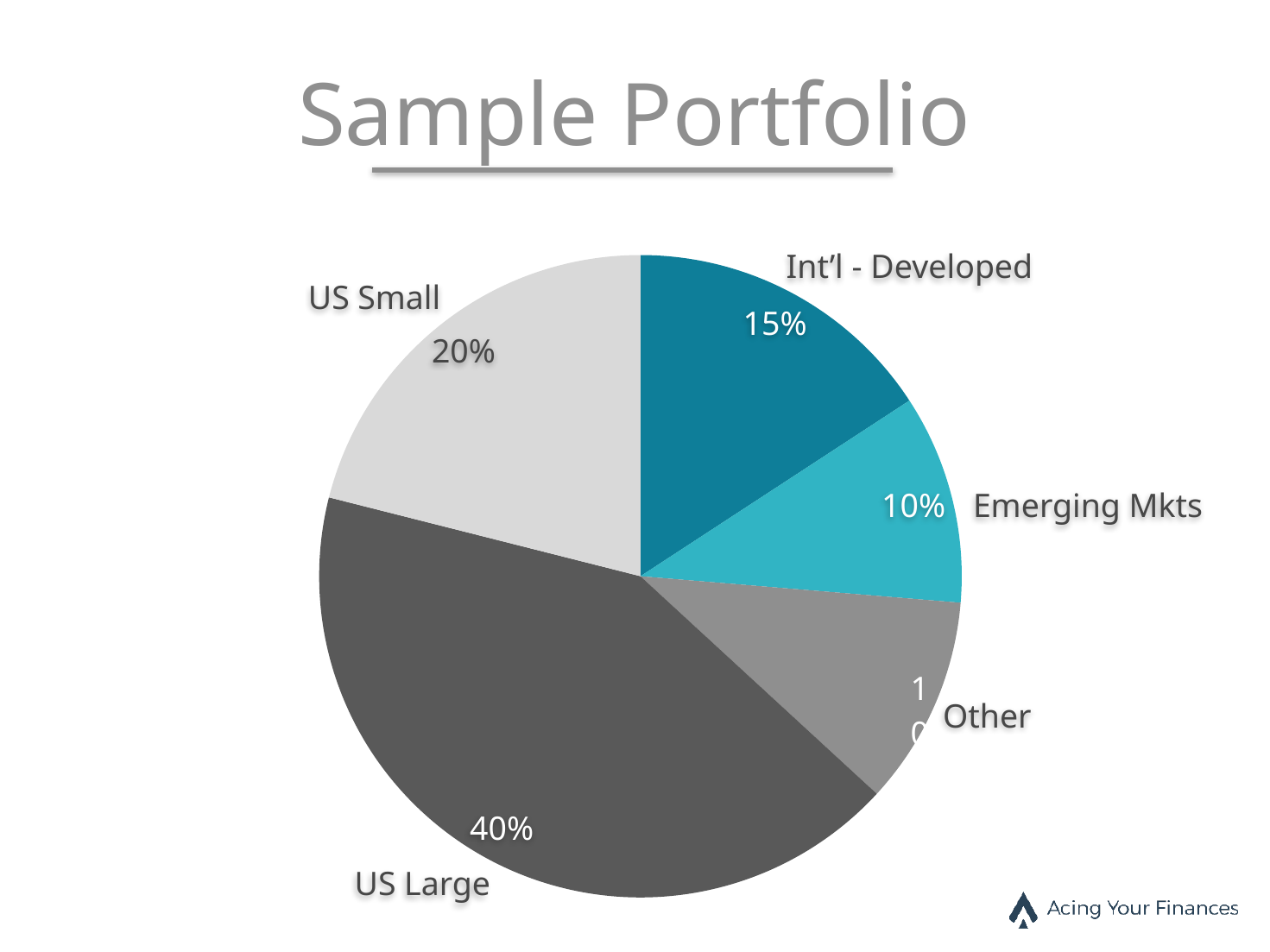
Which is larger, the Int'l - Developed slice or the Emerging Mkts slice? Int'l - Developed What is the difference between the Int'l - Developed share and the Emerging Mkts share? 5% How many slices does the pie chart have? 5 What is the difference between the US Large share and the US Small share? 20% Which is larger, the US Small slice or the Int'l - Developed slice? US Small What share of the portfolio is Emerging Mkts? 10% What kind of chart is shown on the slide? pie chart What share of the portfolio is US Large? 40% Which category has the largest slice of the pie? US Large What is the title of the chart? Sample Portfolio What share of the portfolio is Int'l - Developed? 15% What share of the portfolio is US Small? 20%